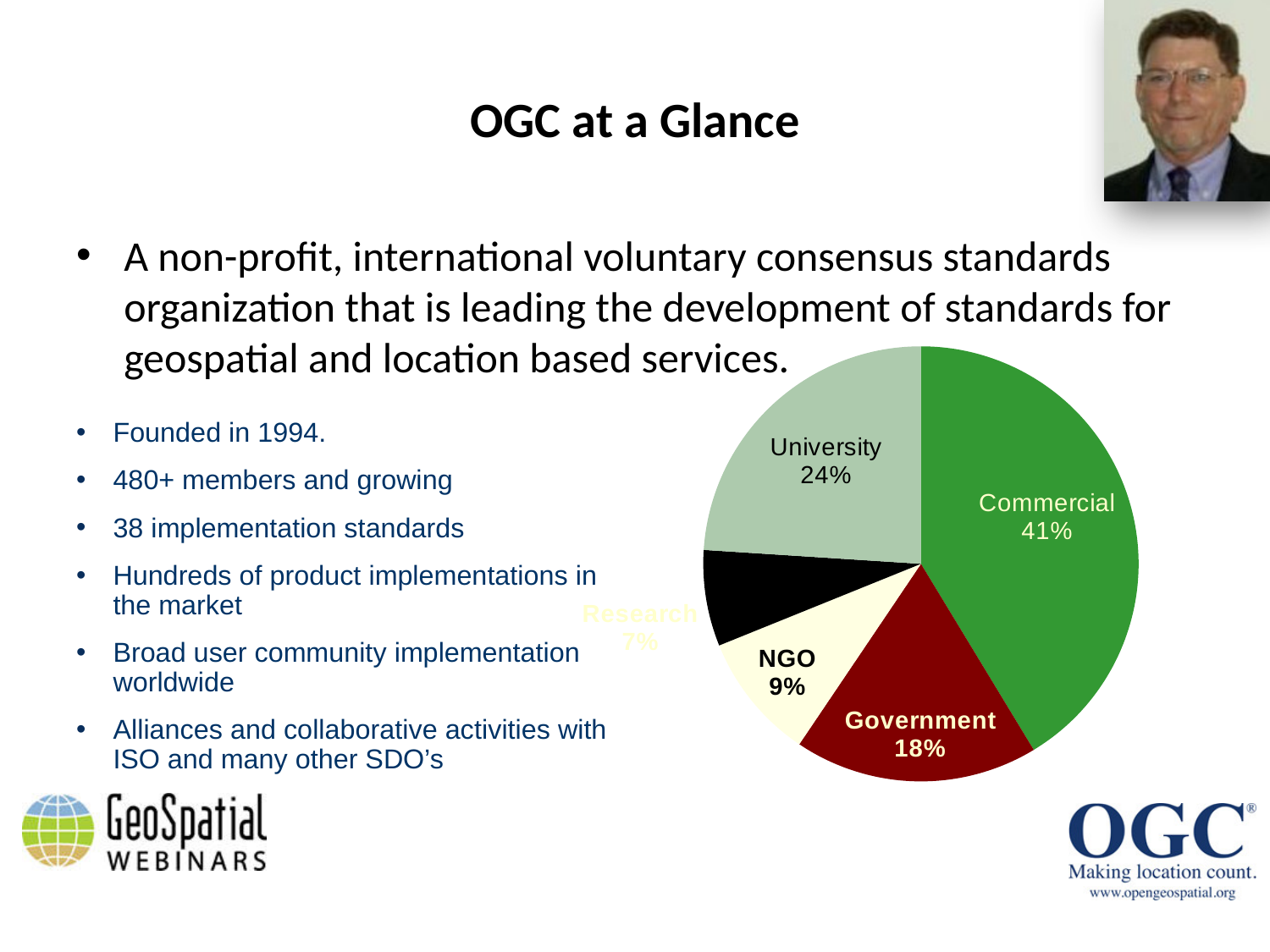
How many slices does the pie chart have? 5 Which is larger, the University slice or the Government slice? University What share of the pie does the Commercial slice represent? 41% What share of the pie does the Government slice represent? 18% What share of the pie does the NGO slice represent? 9% Which category has the largest slice of the pie? Commercial What colour is the Commercial slice of the pie chart? green Which is larger, the NGO slice or the Government slice? Government What is the difference in percentage points between the Commercial and University slices? 17 What share of the pie does the University slice represent? 24% What kind of chart is shown on the slide? pie chart What is the difference in percentage points between the Government and NGO slices? 9